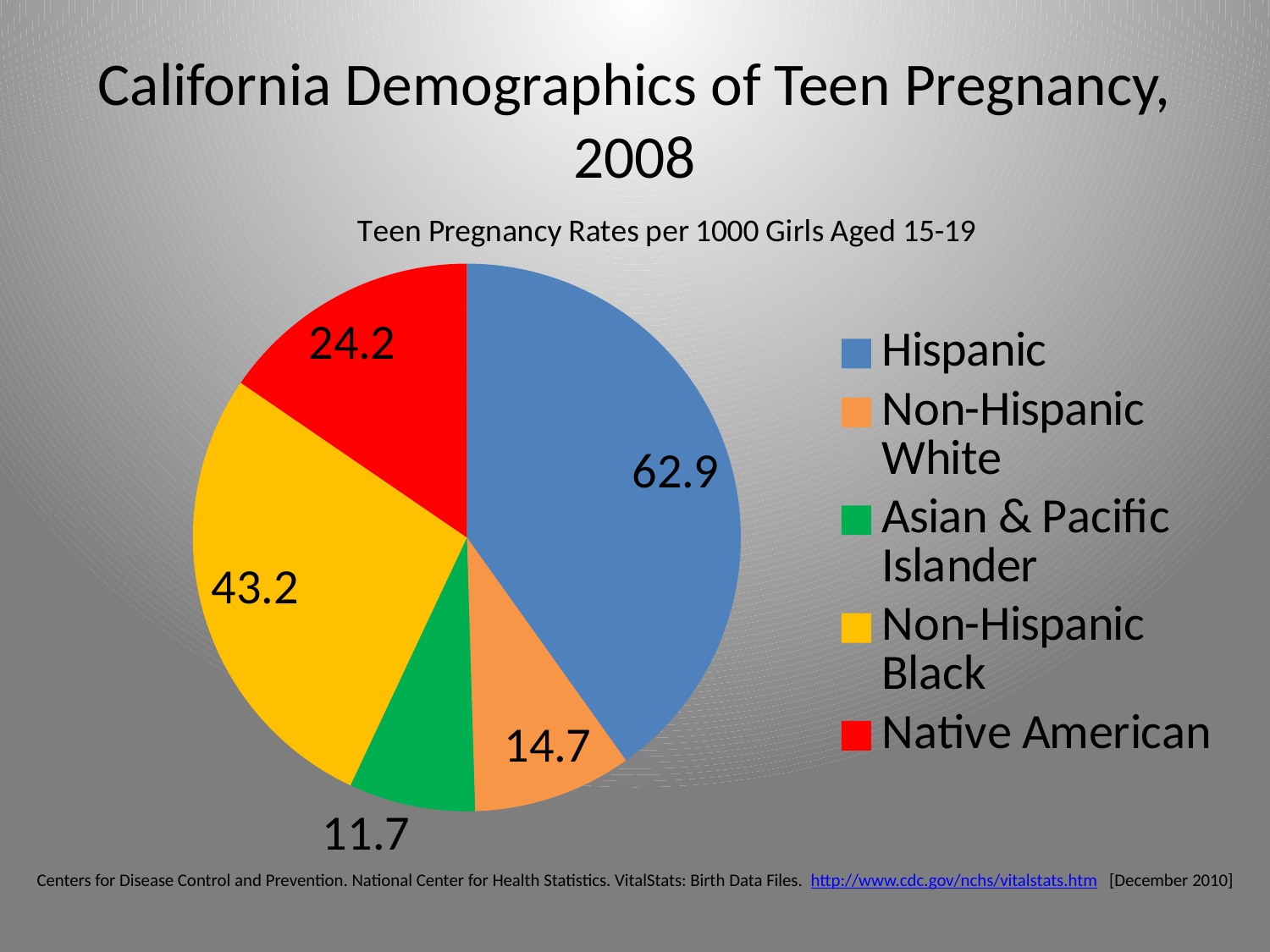
Which group has the highest teen pregnancy rate on the pie chart? Hispanic What value is shown for Non-Hispanic Black on the pie chart? 43.2 What colour represents Non-Hispanic Black in the pie chart? Yellow What is the difference between the Native American rate and the Non-Hispanic White rate? 9.5 What value is shown for Asian & Pacific Islander on the pie chart? 11.7 What type of chart is shown on the slide? Pie chart Which group has the lowest teen pregnancy rate on the pie chart? Asian & Pacific Islander Which is larger, the rate for Non-Hispanic White or the rate for Native American? Native American What value is shown for Native American on the pie chart? 24.2 How many groups are shown in the pie chart? 5 What is the difference between the Hispanic rate and the Non-Hispanic Black rate? 19.7 What is the teen pregnancy rate for Hispanic girls shown on the pie chart? 62.9